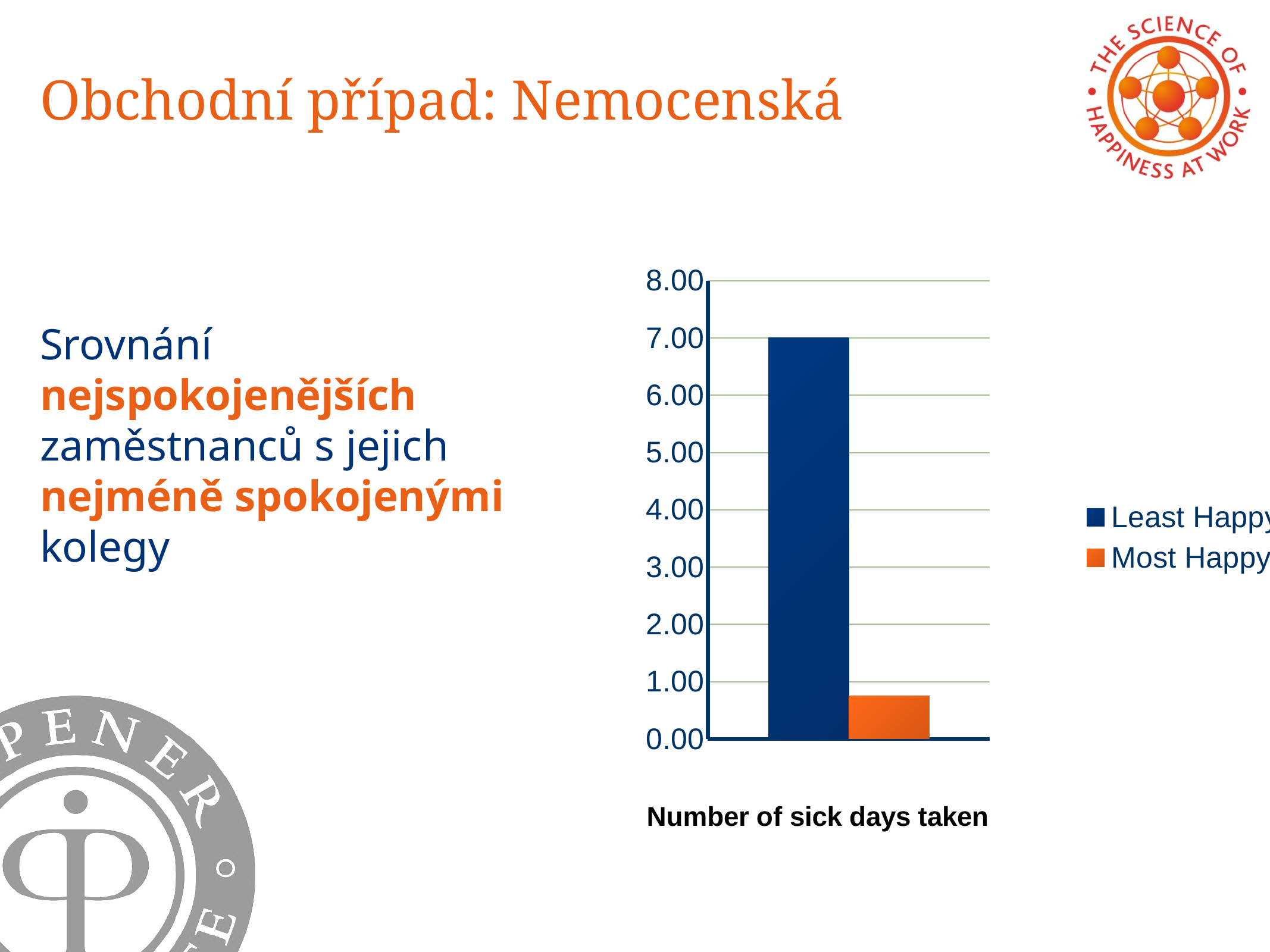
Is the value for Least Happy greater or less than 6.00? greater How many categories are shown on the x axis of the chart? 1 What is the label shown beneath the chart's x axis? Number of sick days taken What kind of chart is shown on the slide? bar chart Which series has the higher number of sick days taken, Least Happy or Most Happy? Least Happy What colour is the bar for the Most Happy series? orange How many series does the chart legend list? 2 What is the number of sick days taken for the Least Happy series? 7.00 Which series has the lowest value in the chart? Most Happy Is the value for Most Happy greater or less than 1.00? less Which series has the highest value in the chart? Least Happy